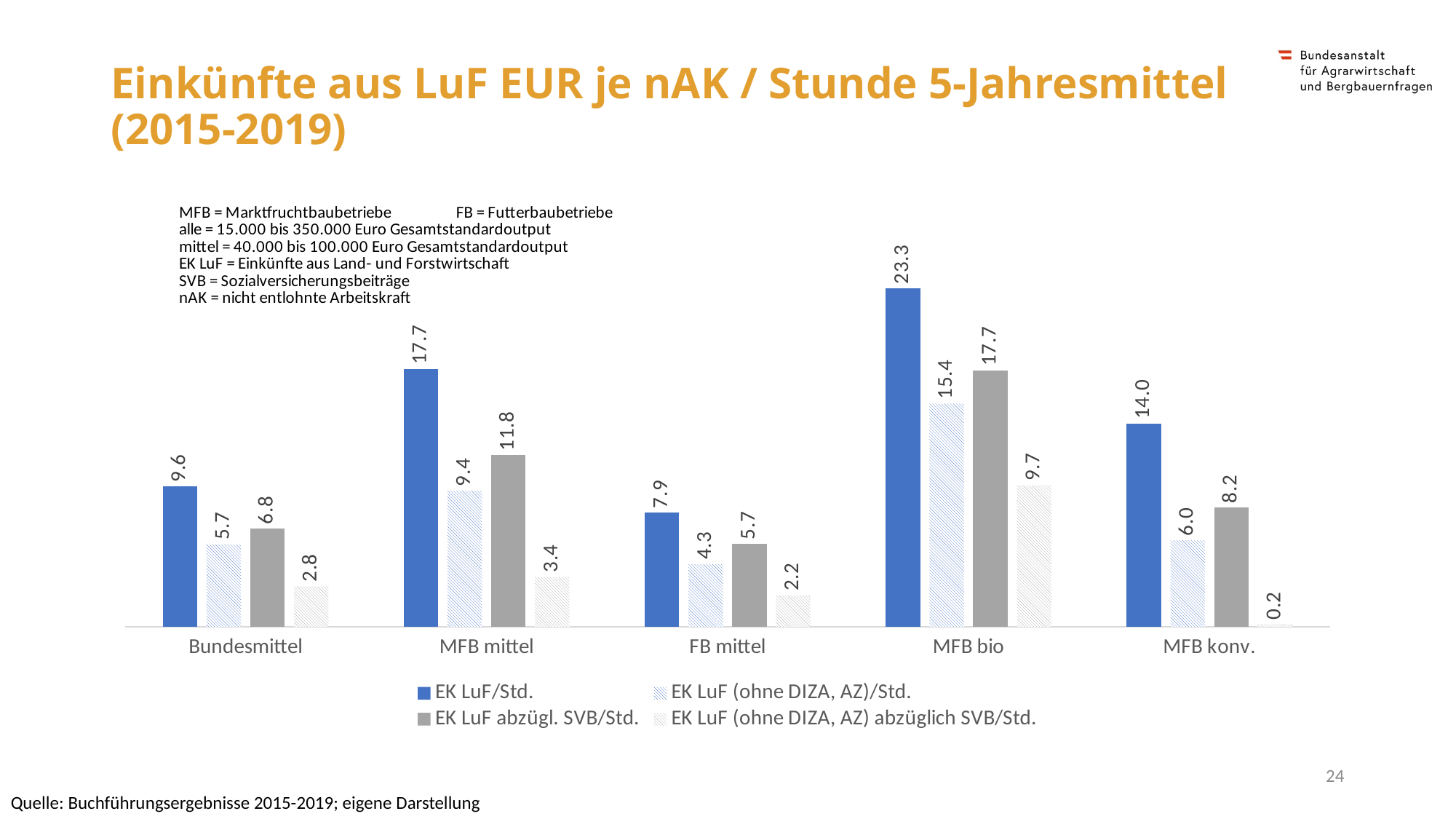
What colour are the EK LuF/Std. bars? Blue Which is larger: EK LuF abzügl. SVB/Std. for MFB mittel or for MFB konv.? MFB mittel What is the value of EK LuF (ohne DIZA, AZ)/Std. for FB mittel? 4.3 What is the difference between EK LuF/Std. for MFB bio and MFB konv.? 9.3 What kind of chart is shown on the slide? Bar chart How many categories are shown on the x axis? 5 What is the value of EK LuF (ohne DIZA, AZ) abzüglich SVB/Std. for MFB konv.? 0.2 What is the value of EK LuF/Std. for MFB bio? 23.3 Which category has the lowest EK LuF (ohne DIZA, AZ) abzüglich SVB/Std. value? MFB konv. How many series does the legend list? 4 Which category has the highest EK LuF/Std. value? MFB bio What is the value of EK LuF abzügl. SVB/Std. for Bundesmittel? 6.8